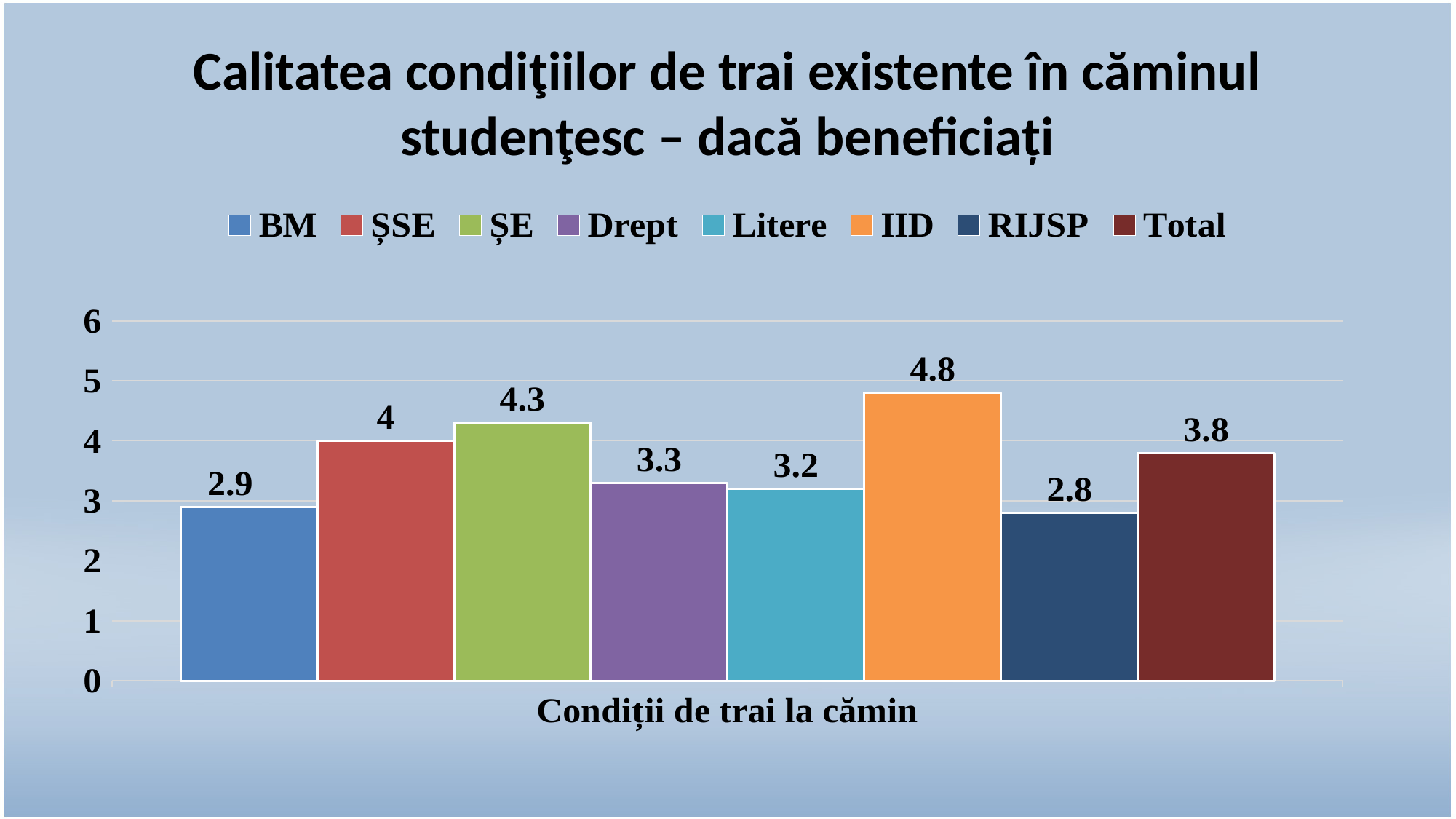
What is the value for Total? 3.8 What is the x-axis label of the chart? Condiții de trai la cămin What is the difference between the values for ȘE and Drept? 1 What is the value for IID? 4.8 How many series does the legend list? 8 Which series has the highest value? IID What is the value for BM? 2.9 Is the value for RIJSP greater or less than 3? less Which is larger, the value for ȘSE or the value for Litere? ȘSE What kind of chart is shown on the slide? bar chart What colour is the bar for IID? orange Which series has the lowest value? RIJSP